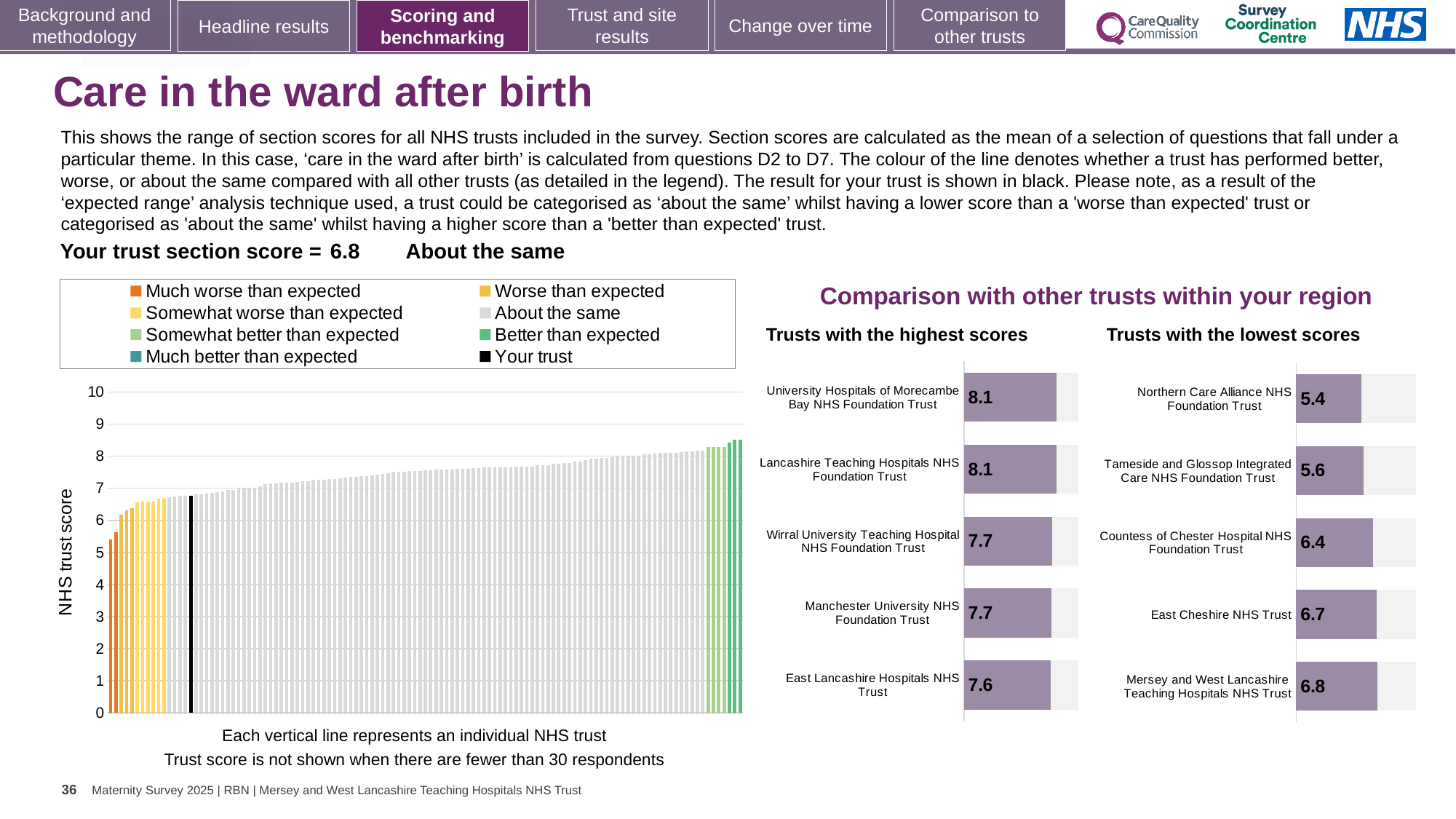
What kind of chart is the NHS trust score chart on the left of the slide? Bar chart In the 'Trusts with the lowest scores' chart, what is the difference between the scores of Mersey and West Lancashire Teaching Hospitals NHS Trust and Northern Care Alliance NHS Foundation Trust? 1.4 How many trusts are shown in the 'Trusts with the highest scores' chart? 5 In the 'Trusts with the highest scores' chart, which trust has the lowest score? East Lancashire Hospitals NHS Trust In the 'Trusts with the highest scores' chart, what is the difference between the scores of University Hospitals of Morecambe Bay NHS Foundation Trust and East Lancashire Hospitals NHS Trust? 0.5 In the 'Trusts with the highest scores' chart, what is the score for East Lancashire Hospitals NHS Trust? 7.6 Which has the higher score: Wirral University Teaching Hospital NHS Foundation Trust in the highest scores chart, or East Cheshire NHS Trust in the lowest scores chart? Wirral University Teaching Hospital NHS Foundation Trust In the 'Trusts with the lowest scores' chart, what is the score for Tameside and Glossop Integrated Care NHS Foundation Trust? 5.6 In the 'Trusts with the lowest scores' chart, which trust has the lowest score? Northern Care Alliance NHS Foundation Trust How many entries does the legend of the NHS trust score chart list? 8 In the NHS trust score chart, is the value for the black 'Your trust' bar greater or less than 5? greater In the 'Trusts with the lowest scores' chart, what is the score for Countess of Chester Hospital NHS Foundation Trust? 6.4